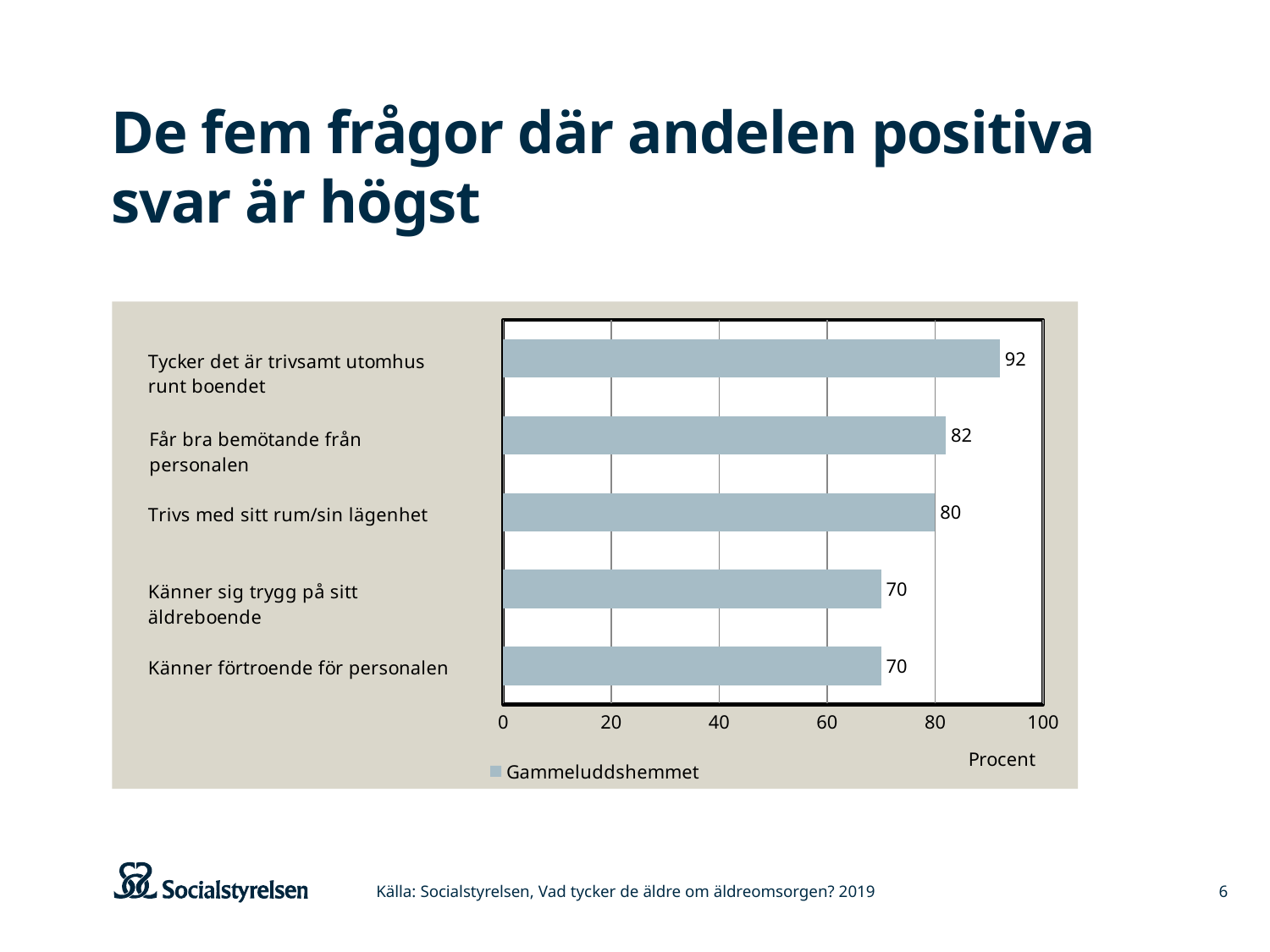
What is the value for "Trivs med sitt rum/sin lägenhet"? 80 How many categories are shown in the chart? 5 Which is larger, the value for "Får bra bemötande från personalen" or for "Känner sig trygg på sitt äldreboende"? Får bra bemötande från personalen What is the value for "Tycker det är trivsamt utomhus runt boendet"? 92 Which category has the highest value? Tycker det är trivsamt utomhus runt boendet What is the value for "Får bra bemötande från personalen"? 82 How many series does the legend list? 1 What is the difference between the values for "Tycker det är trivsamt utomhus runt boendet" and "Får bra bemötande från personalen"? 10 What is the name of the series in the legend? Gammeluddshemmet What kind of chart is shown on the slide? Bar chart What is the difference between the values for "Trivs med sitt rum/sin lägenhet" and "Känner sig trygg på sitt äldreboende"? 10 What is the value for "Känner förtroende för personalen"? 70